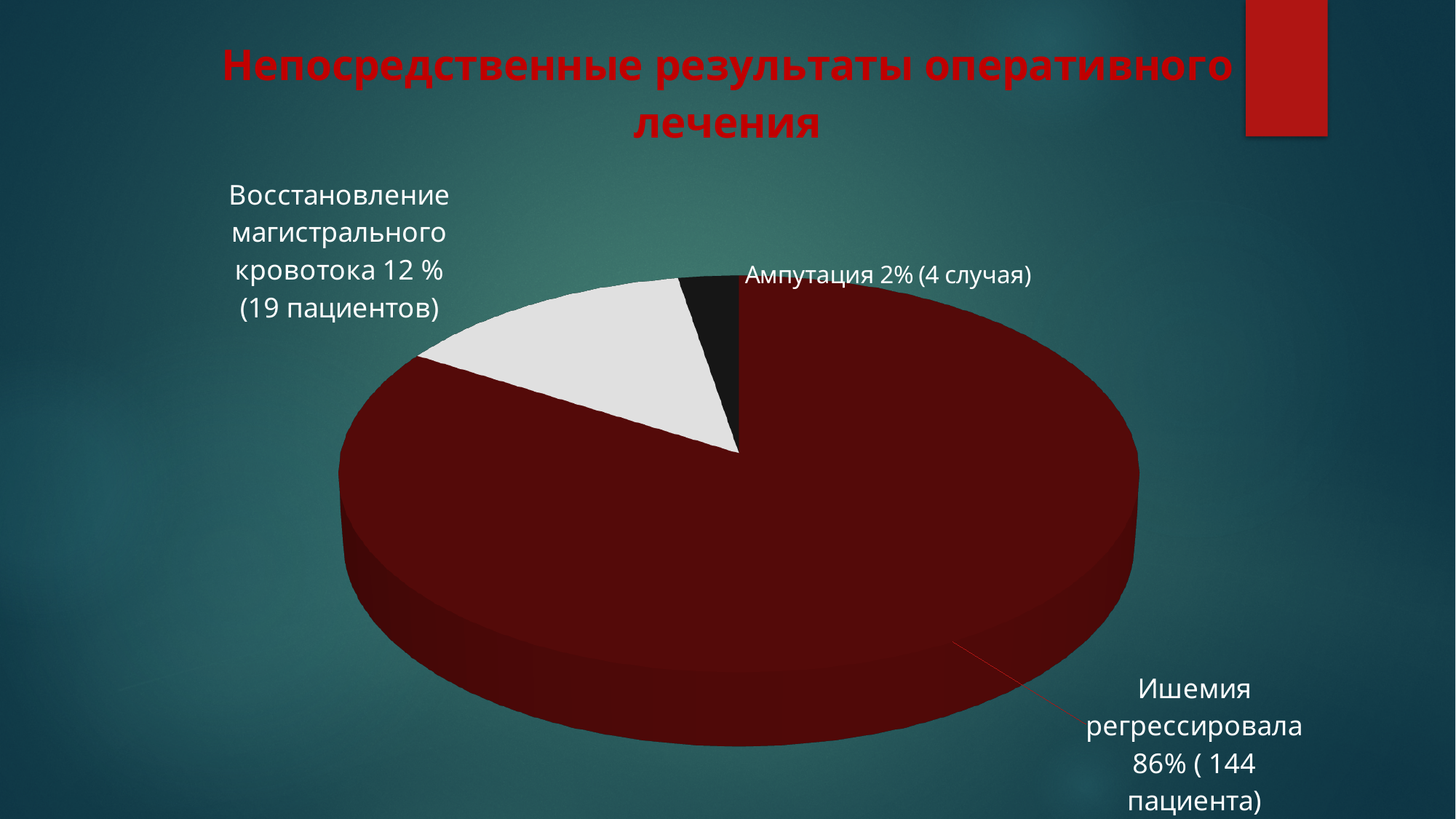
What share of the pie does "Ишемия регрессировала" represent? 86% What kind of chart is shown on the slide? Pie chart How many cases are in the "Ампутация" category? 4 случая How many patients are in the "Восстановление магистрального кровотока" category? 19 пациентов What share of the pie does "Восстановление магистрального кровотока" represent? 12 % How many patients are in the "Ишемия регрессировала" category? 144 пациента What share of the pie does "Ампутация" represent? 2% Which category has the largest slice of the pie? Ишемия регрессировала How many slices does the pie chart have? 3 What is the title of the chart on the slide? Непосредственные результаты оперативного лечения What is the difference in percentage points between "Ишемия регрессировала" and "Восстановление магистрального кровотока"? 74 Which category has the smallest slice of the pie? Ампутация